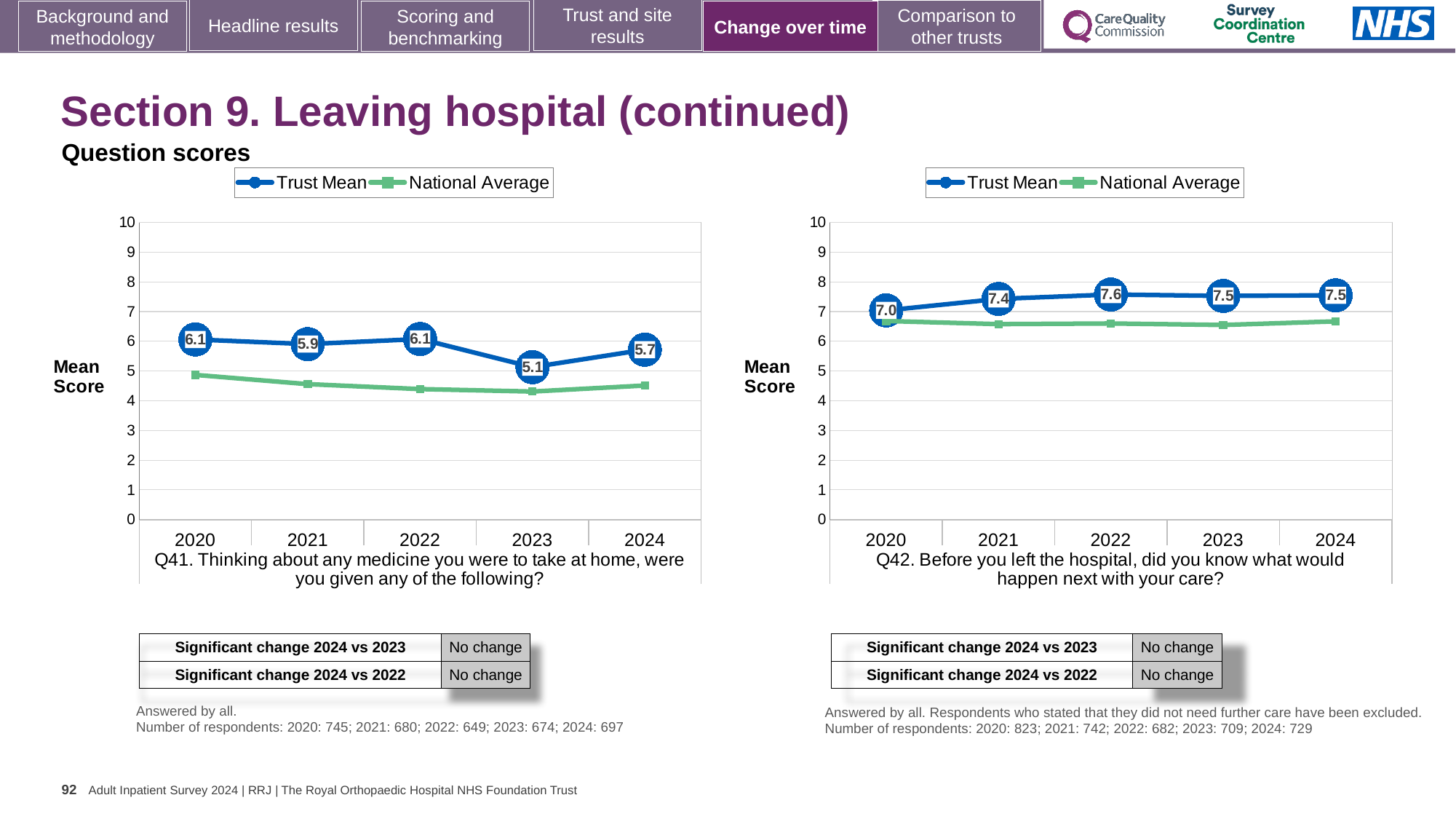
In the Q41 chart, which is larger in 2020: the Trust Mean or the National Average? Trust Mean In the Q42 chart, what is the Trust Mean value for 2020? 7.0 In the Q42 chart, is the National Average for 2021 greater or less than 7? less What kind of chart is the Q42 chart? Line chart How many years are shown on the x axis of the Q42 chart? 5 In the Q42 chart, which year has the highest Trust Mean? 2022 How many series does the legend of the Q41 chart list? 2 In the Q41 chart, is the Trust Mean for 2024 greater or less than 5? greater In the Q42 chart, what is the difference between the Trust Mean in 2022 and in 2020? 0.6 In the Q41 chart, what is the Trust Mean value for 2023? 5.1 In the Q41 chart, what is the difference between the Trust Mean in 2022 and in 2023? 1.0 In the Q41 chart, which year has the lowest Trust Mean? 2023